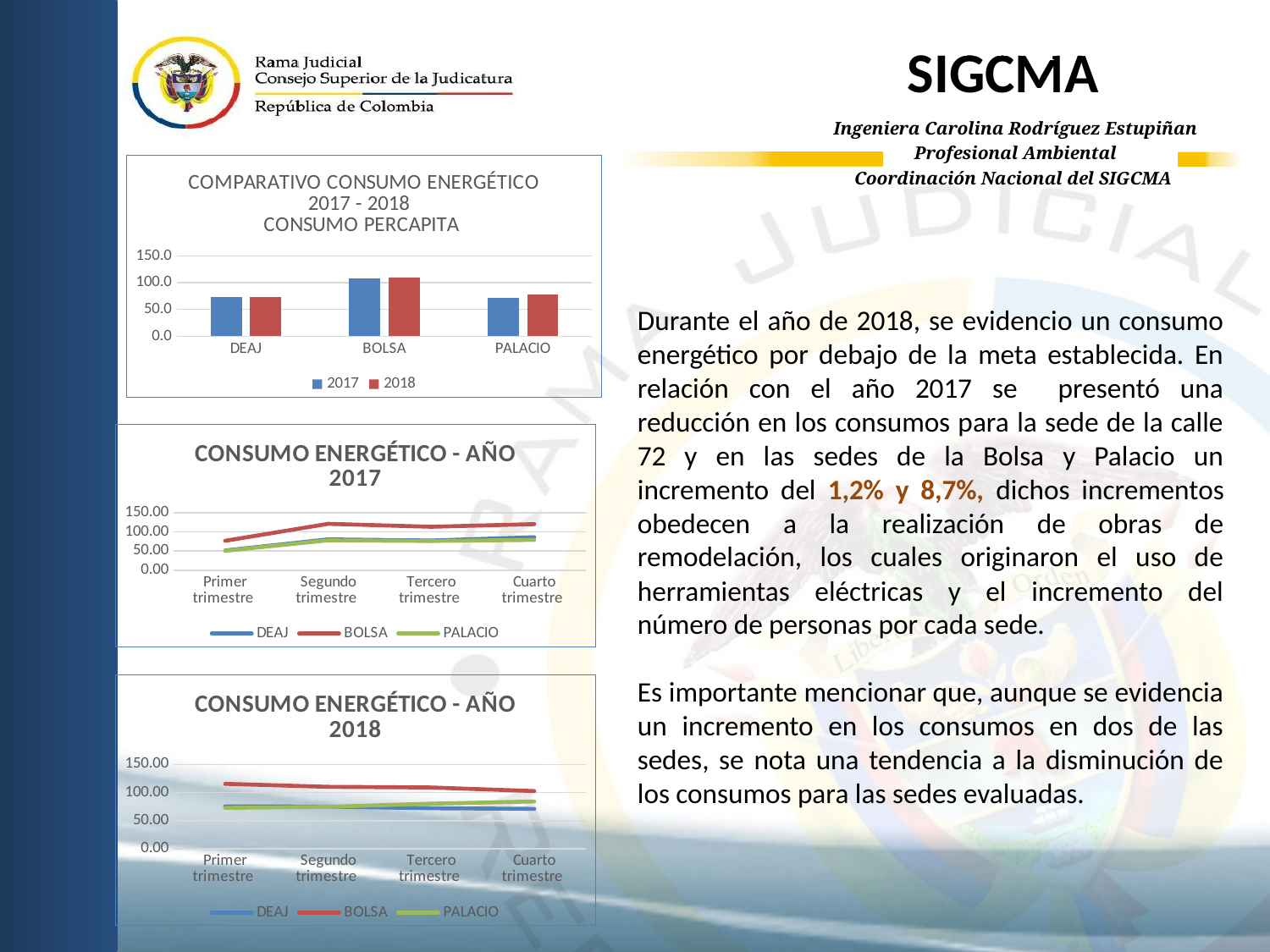
In the bottom chart 'CONSUMO ENERGÉTICO - AÑO 2018', does the BOLSA line rise or fall from Primer trimestre to Cuarto trimestre? fall In the bottom chart 'CONSUMO ENERGÉTICO - AÑO 2018', is the DEAJ value for Cuarto trimestre greater or less than 100.00? less What kind of chart is the top chart titled 'COMPARATIVO CONSUMO ENERGÉTICO 2017 - 2018 CONSUMO PERCAPITA'? bar chart In the top chart 'COMPARATIVO CONSUMO ENERGÉTICO 2017 - 2018', which category has the highest value for 2017? BOLSA In the top chart 'COMPARATIVO CONSUMO ENERGÉTICO 2017 - 2018', is the 2017 value for DEAJ greater or less than 100.0? less In the middle chart 'CONSUMO ENERGÉTICO - AÑO 2017', which series has the highest values across all quarters? BOLSA In the middle chart 'CONSUMO ENERGÉTICO - AÑO 2017', how many series does the legend list? 3 In the top chart 'COMPARATIVO CONSUMO ENERGÉTICO 2017 - 2018', is the 2018 value for BOLSA greater or less than 100.0? greater In the top chart 'COMPARATIVO CONSUMO ENERGÉTICO 2017 - 2018', how many categories are shown on the x axis? 3 In the top chart 'COMPARATIVO CONSUMO ENERGÉTICO 2017 - 2018', how many series does the legend list? 2 In the top chart 'COMPARATIVO CONSUMO ENERGÉTICO 2017 - 2018', which is larger for 2018: BOLSA or PALACIO? BOLSA What kind of chart is the middle chart titled 'CONSUMO ENERGÉTICO - AÑO 2017'? line chart